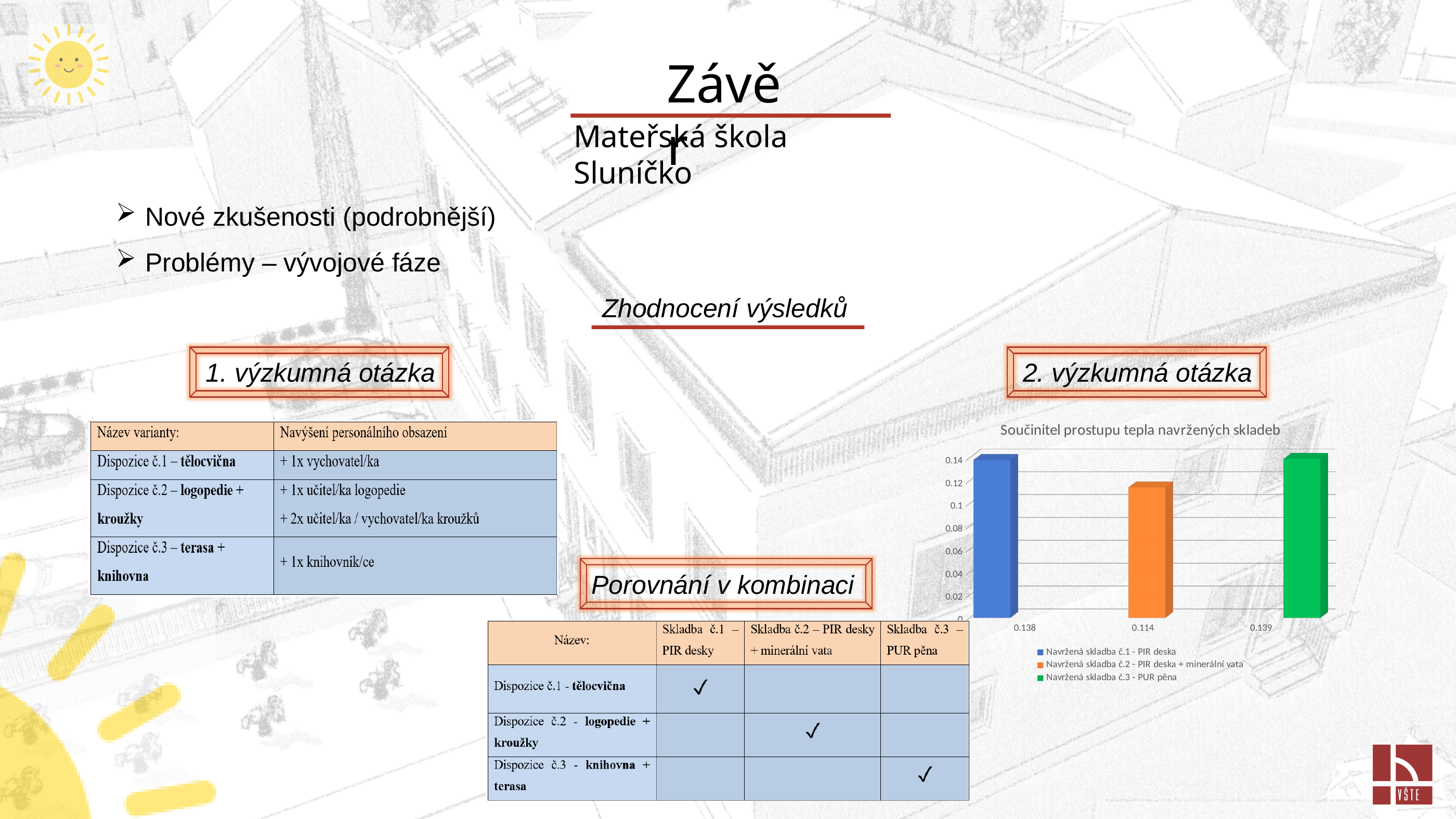
In the chart 'Součinitel prostupu tepla navržených skladeb', what is the value for Navržená skladba č.1 - PIR deska? 0.138 In the chart 'Součinitel prostupu tepla navržených skladeb', what is the value for Navržená skladba č.2 - PIR deska + minerální vata? 0.114 What kind of chart is 'Součinitel prostupu tepla navržených skladeb'? Bar chart In the chart 'Součinitel prostupu tepla navržených skladeb', is the value for skladba č.2 - PIR deska + minerální vata greater or less than 0.12? less In the chart 'Součinitel prostupu tepla navržených skladeb', which skladba has the lowest value? Navržená skladba č.2 - PIR deska + minerální vata How many entries does the legend of the chart 'Součinitel prostupu tepla navržených skladeb' list? 3 In the chart 'Součinitel prostupu tepla navržených skladeb', what is the difference between the values for skladba č.1 - PIR deska and skladba č.2 - PIR deska + minerální vata? 0.024 How many bars are plotted in the chart 'Součinitel prostupu tepla navržených skladeb'? 3 In the chart 'Součinitel prostupu tepla navržených skladeb', which is larger: the value for skladba č.1 - PIR deska or skladba č.2 - PIR deska + minerální vata? Skladba č.1 - PIR deska In the chart 'Součinitel prostupu tepla navržených skladeb', what colour is the bar for Navržená skladba č.3 - PUR pěna? Green In the chart 'Součinitel prostupu tepla navržených skladeb', what is the value for Navržená skladba č.3 - PUR pěna? 0.139 In the chart 'Součinitel prostupu tepla navržených skladeb', what is the difference between the values for skladba č.3 - PUR pěna and skladba č.2 - PIR deska + minerální vata? 0.025